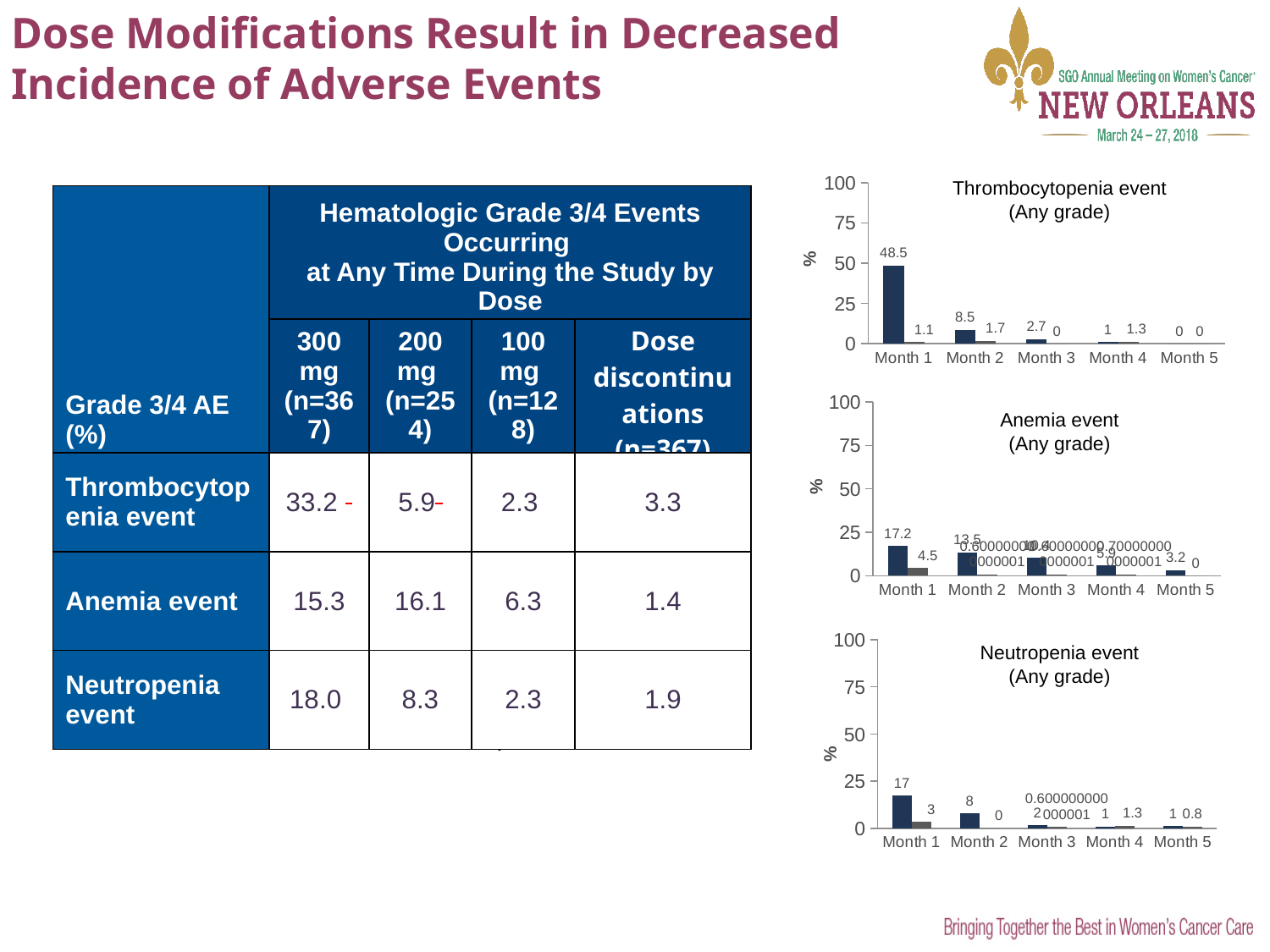
How many months are shown on the x axis of the Neutropenia event (Any grade) chart? 5 In the Thrombocytopenia event (Any grade) chart, what is the difference between the first-bar values for Month 1 and Month 2? 40 In the Neutropenia event (Any grade) chart, what is the value of the first bar for Month 1? 17 In the Thrombocytopenia event (Any grade) chart, what is the value of the first bar for Month 1? 48.5 In the Anemia event (Any grade) chart, do the first-bar values rise or fall from Month 1 to Month 5? fall In the Anemia event (Any grade) chart, what is the value of the second bar for Month 1? 4.5 In the Neutropenia event (Any grade) chart, which is larger, the first-bar value for Month 1 or for Month 2? Month 1 In the Thrombocytopenia event (Any grade) chart, is the first-bar value for Month 1 greater or less than 25? greater In the Anemia event (Any grade) chart, what is the value of the first bar for Month 1? 17.2 In the Thrombocytopenia event (Any grade) chart, which month has the highest first-bar value? Month 1 In the Thrombocytopenia event (Any grade) chart, what is the value of the first bar for Month 2? 8.5 What kind of chart is the Thrombocytopenia event (Any grade) chart? bar chart